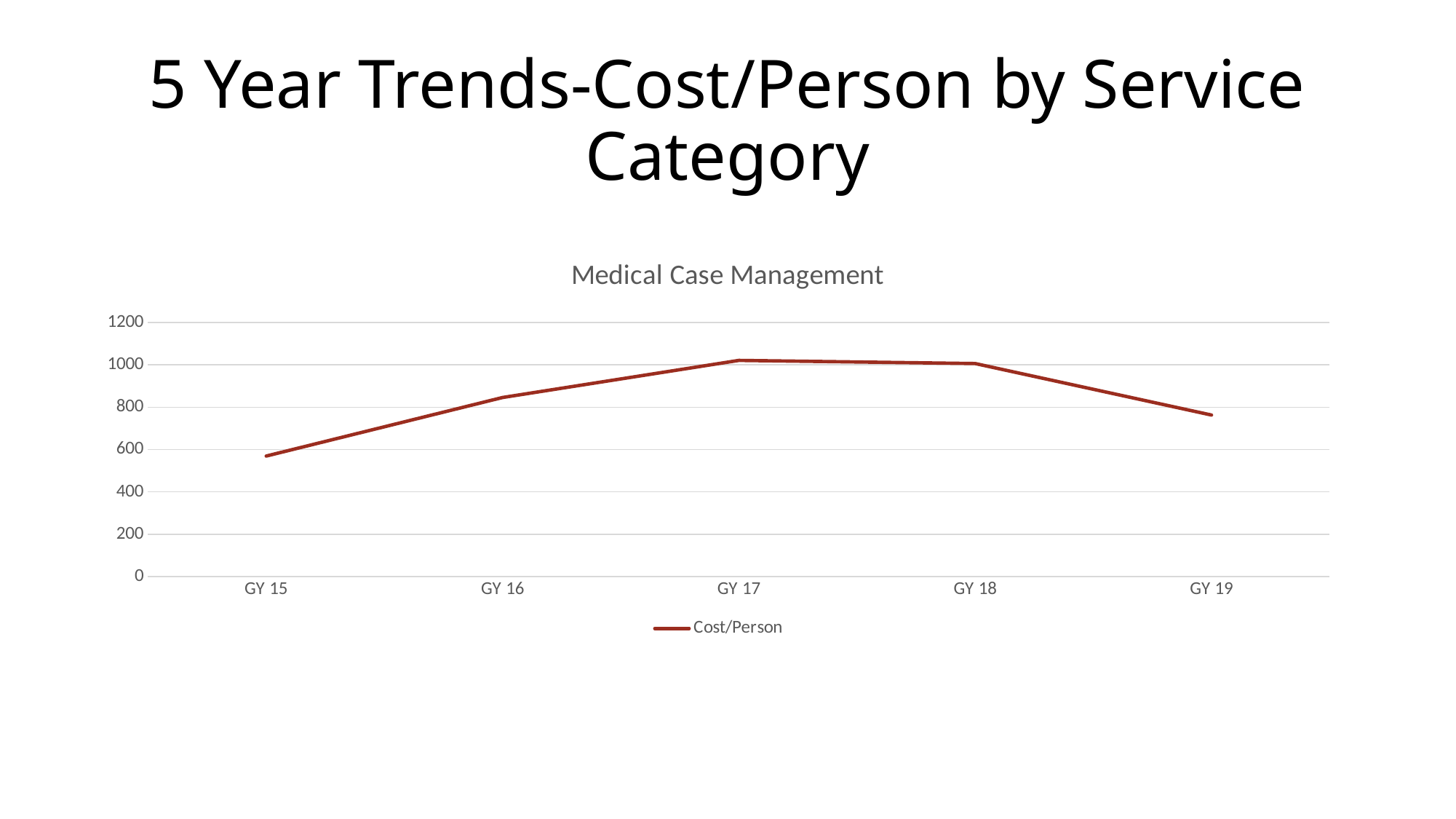
Does the Cost/Person rise or fall from GY 18 to GY 19? Fall What is the title of the chart? Medical Case Management What kind of chart is shown on the slide? Line chart Is the Cost/Person for GY 15 greater or less than 600? less How many series does the legend list? 1 Is the Cost/Person for GY 16 greater or less than 800? greater Which is larger, the Cost/Person for GY 16 or for GY 19? GY 16 Is the Cost/Person for GY 19 greater or less than 800? less How many grant years are plotted on the x axis? 5 Which grant year has the lowest Cost/Person? GY 15 Does the Cost/Person rise or fall from GY 15 to GY 17? Rise What series name does the legend show? Cost/Person